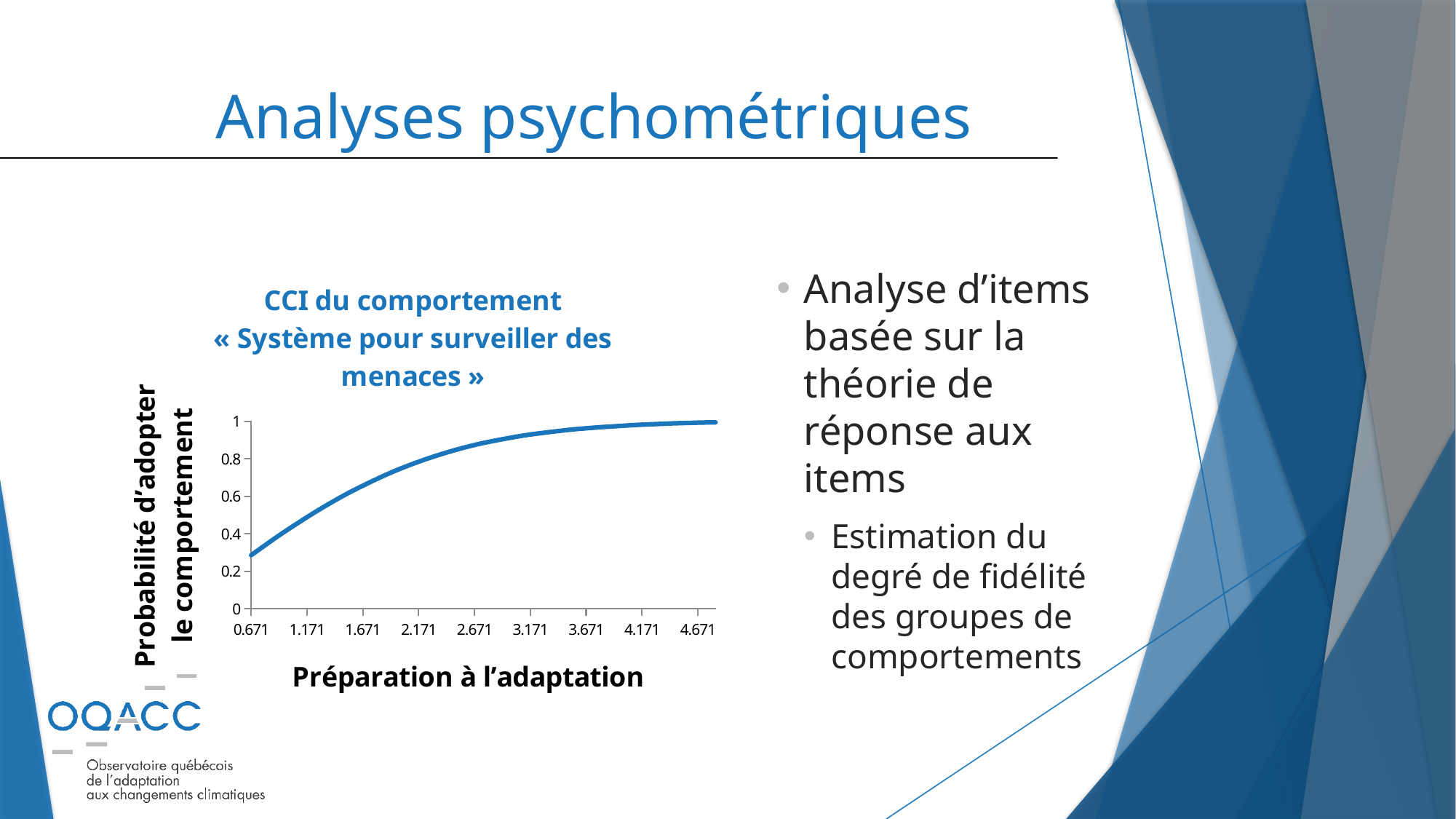
What kind of chart is shown on the slide? line chart Is the value of the curve at 0.671 greater or less than 0.2? greater Is the value of the curve at 1.671 greater or less than 0.4? greater Is the value of the curve at 1.171 greater or less than 0.8? less What is the label of the x axis of the chart? Préparation à l'adaptation What is the title of the chart? CCI du comportement « Système pour surveiller des menaces » Is the curve's value at 4.671 larger or smaller than its value at 0.671? larger Does the probability rise or fall as Préparation à l'adaptation increases along the x axis? rise How many tick labels are shown on the x axis of the chart? 9